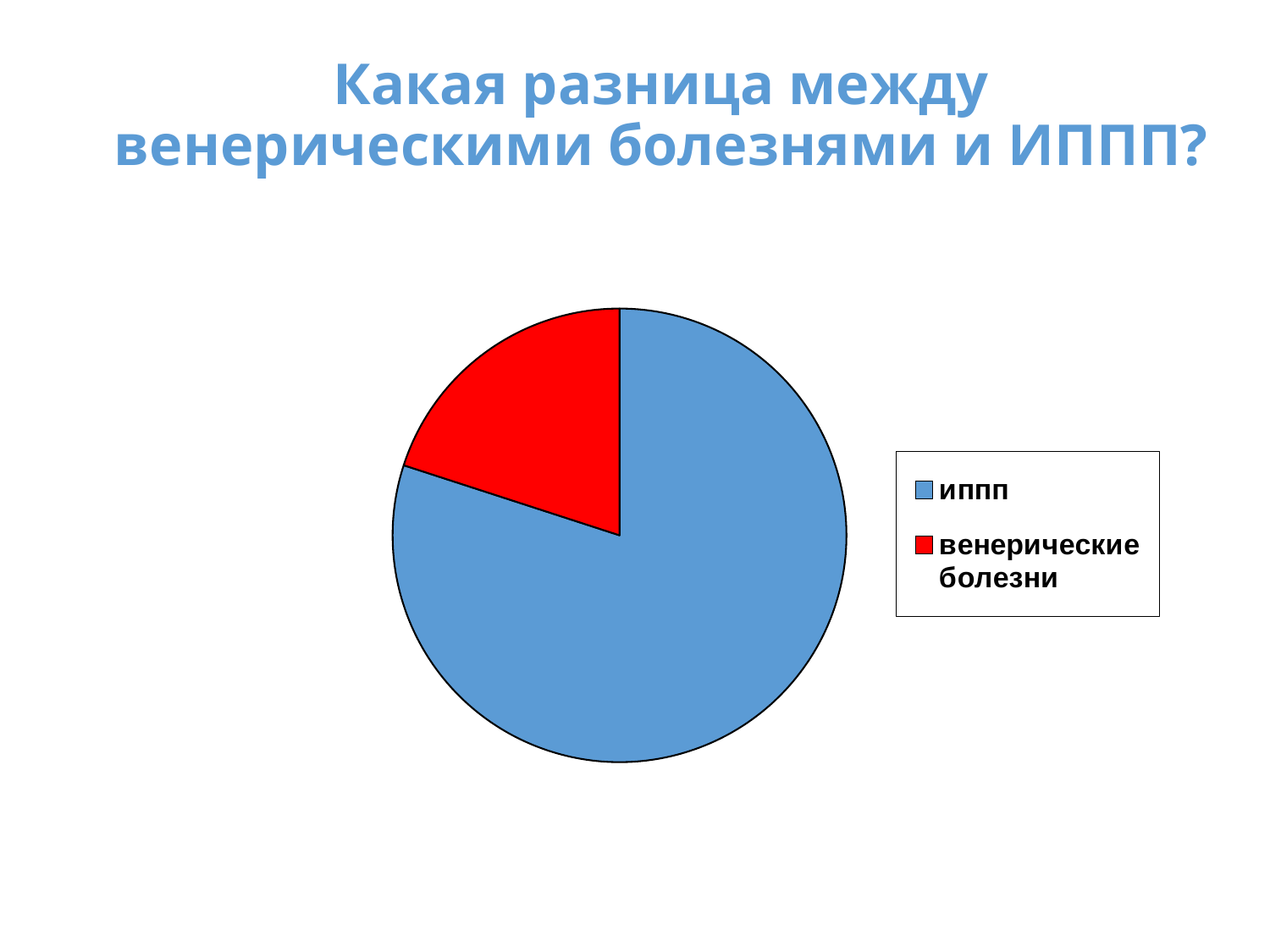
How many slices does the pie chart have? 2 Which slice is larger: иппп or венерические болезни? иппп What kind of chart is shown on the slide? pie chart What colour is the slice for иппп? blue Which category has the largest slice of the pie? иппп How many entries does the legend list? 2 What colour is the slice for венерические болезни? red Which category has the smallest slice of the pie? венерические болезни